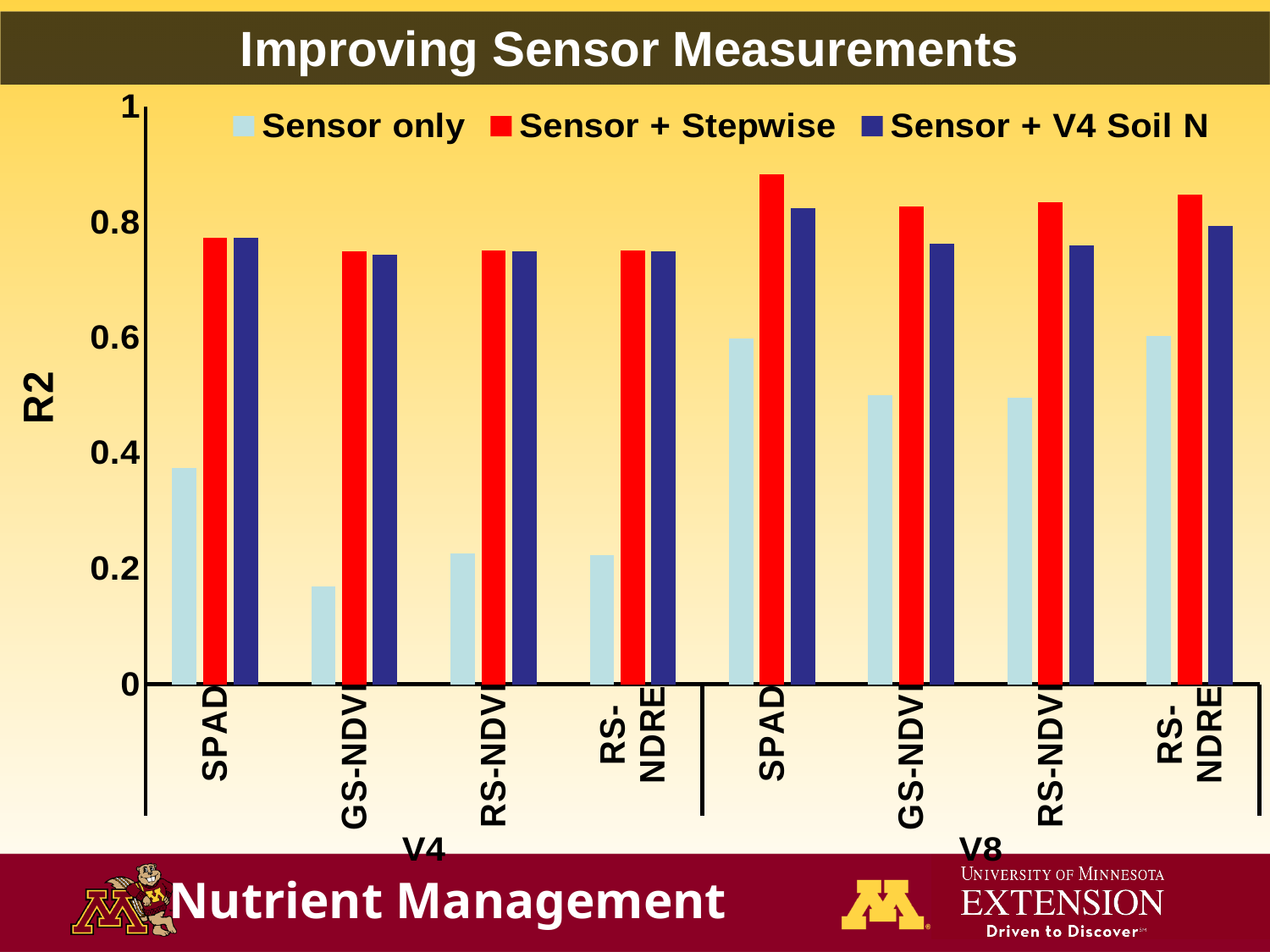
Is the Sensor only value for GS-NDVI in the V4 group greater or less than 0.2? less Which colour represents the Sensor + Stepwise series in the legend? red Is the Sensor only value for GS-NDVI in the V8 group greater or less than 0.6? less Is the Sensor only value for RS-NDVI in the V4 group greater or less than 0.4? less What is the label on the y axis? R2 For the Sensor only series, which is larger: SPAD in the V4 group or SPAD in the V8 group? SPAD in the V8 group Which category has the lowest Sensor only value? GS-NDVI (V4) How many series does the legend list? 3 How many sensor categories are plotted along the x axis (across both the V4 and V8 groups)? 8 For SPAD in the V8 group, which is larger: Sensor + Stepwise or Sensor + V4 Soil N? Sensor + Stepwise What kind of chart is shown on the slide? bar chart